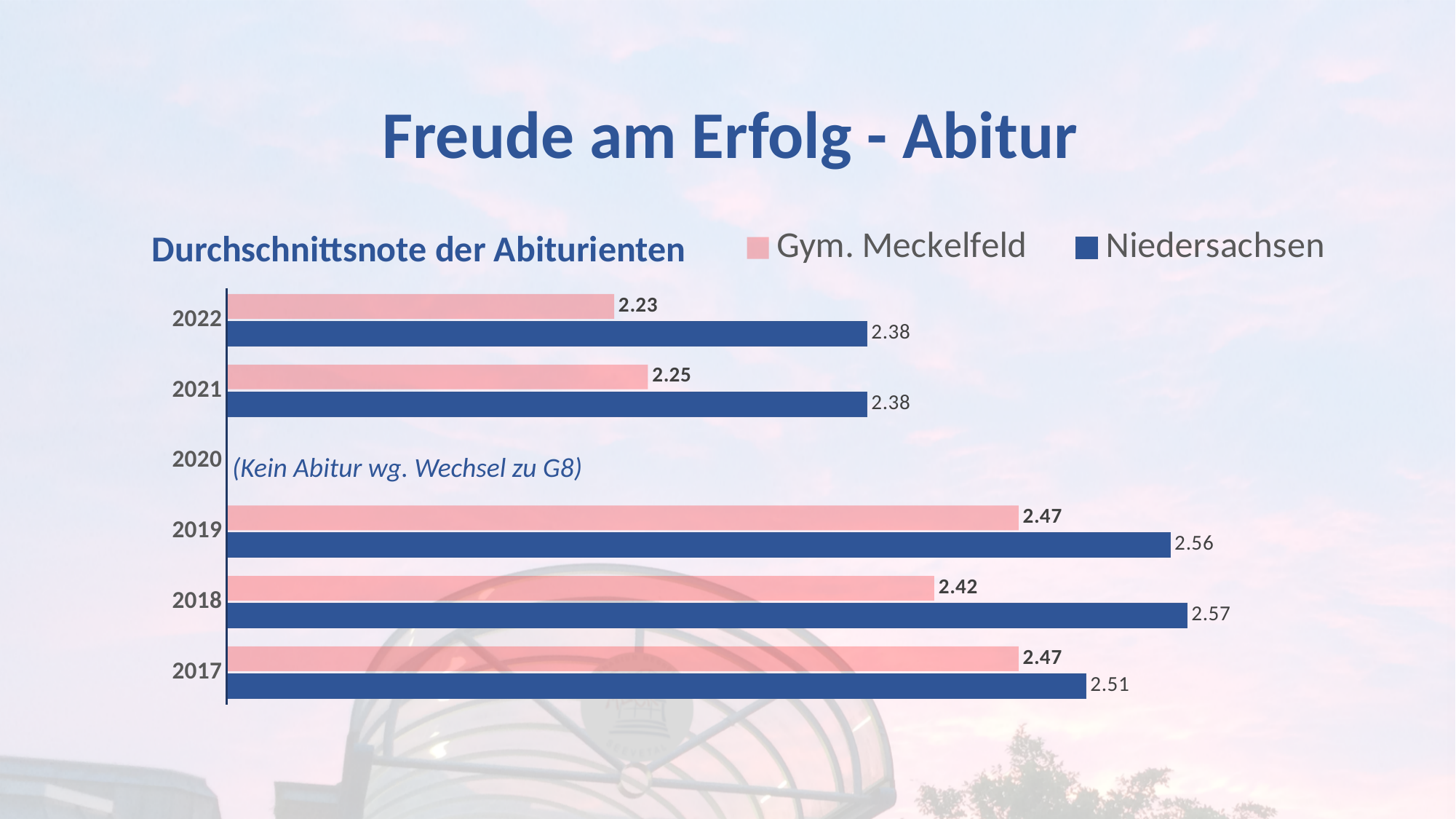
What is the value for Gym. Meckelfeld in 2022? 2.23 How many series does the legend list? 2 For how many years are bars plotted in the chart? 5 What is the value for Gym. Meckelfeld in 2019? 2.47 In 2019, which is larger: the Gym. Meckelfeld value or the Niedersachsen value? Niedersachsen In which year is the Gym. Meckelfeld value lowest? 2022 What is the value for Niedersachsen in 2018? 2.57 Why are there no bars for 2020 according to the chart? Kein Abitur wg. Wechsel zu G8 What is the value for Niedersachsen in 2021? 2.38 What is the difference between the Niedersachsen and Gym. Meckelfeld values in 2017? 0.04 What kind of chart is shown on the slide? Bar chart What is the difference between the Niedersachsen and Gym. Meckelfeld values in 2022? 0.15